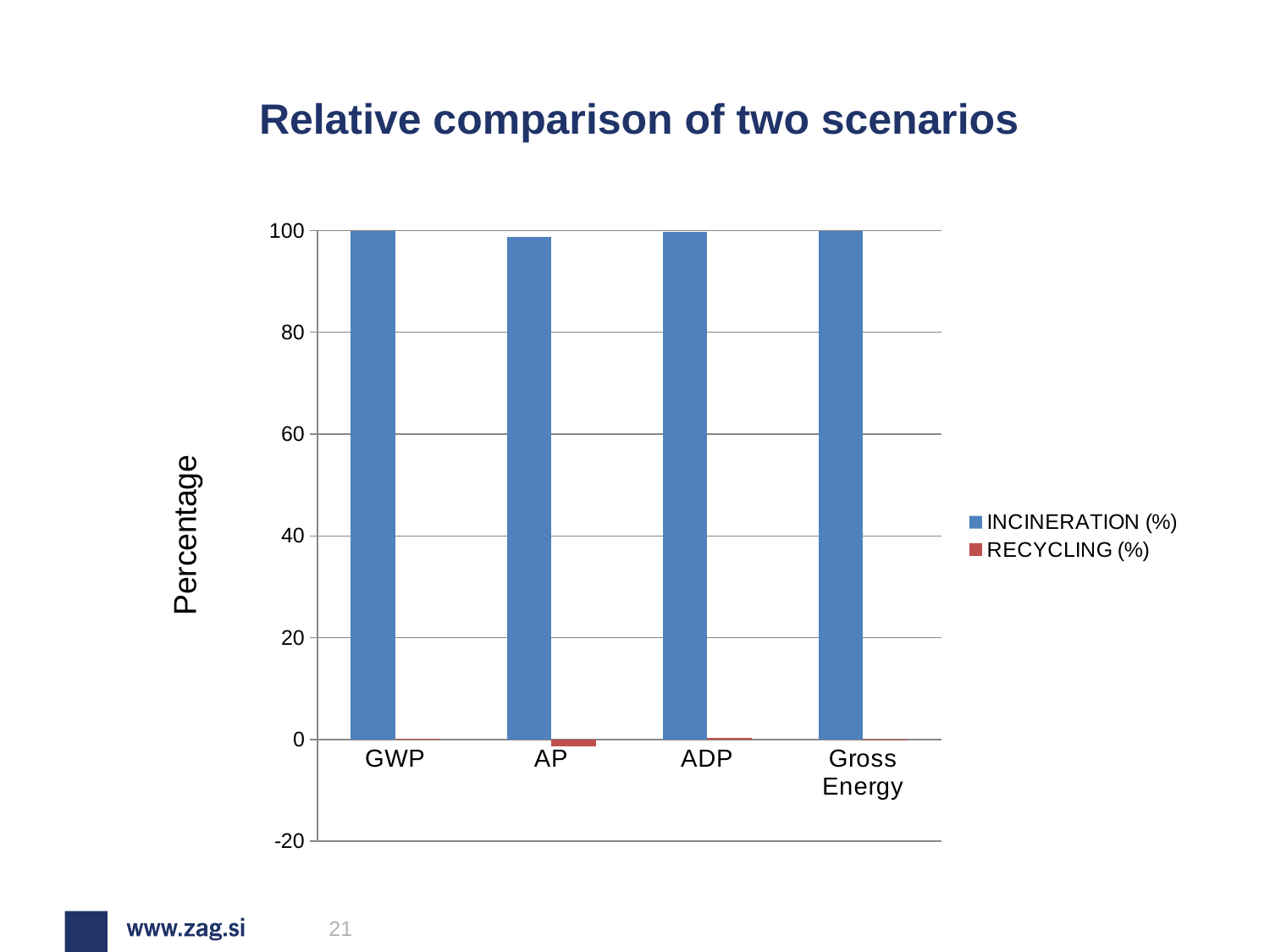
How many categories are shown on the x axis of the chart? 4 How many series does the chart's legend list? 2 What kind of chart is shown on the slide? bar chart Is the INCINERATION (%) value for GWP greater or less than 80? greater Is the INCINERATION (%) value for AP greater or less than 60? greater What is the label of the vertical axis? Percentage For Gross Energy, which series has the larger value, INCINERATION (%) or RECYCLING (%)? INCINERATION (%) Which category has the lowest RECYCLING (%) value? AP For ADP, which series has the larger value, INCINERATION (%) or RECYCLING (%)? INCINERATION (%) Is the RECYCLING (%) value for Gross Energy greater or less than 20? less What is the title of the chart on the slide? Relative comparison of two scenarios